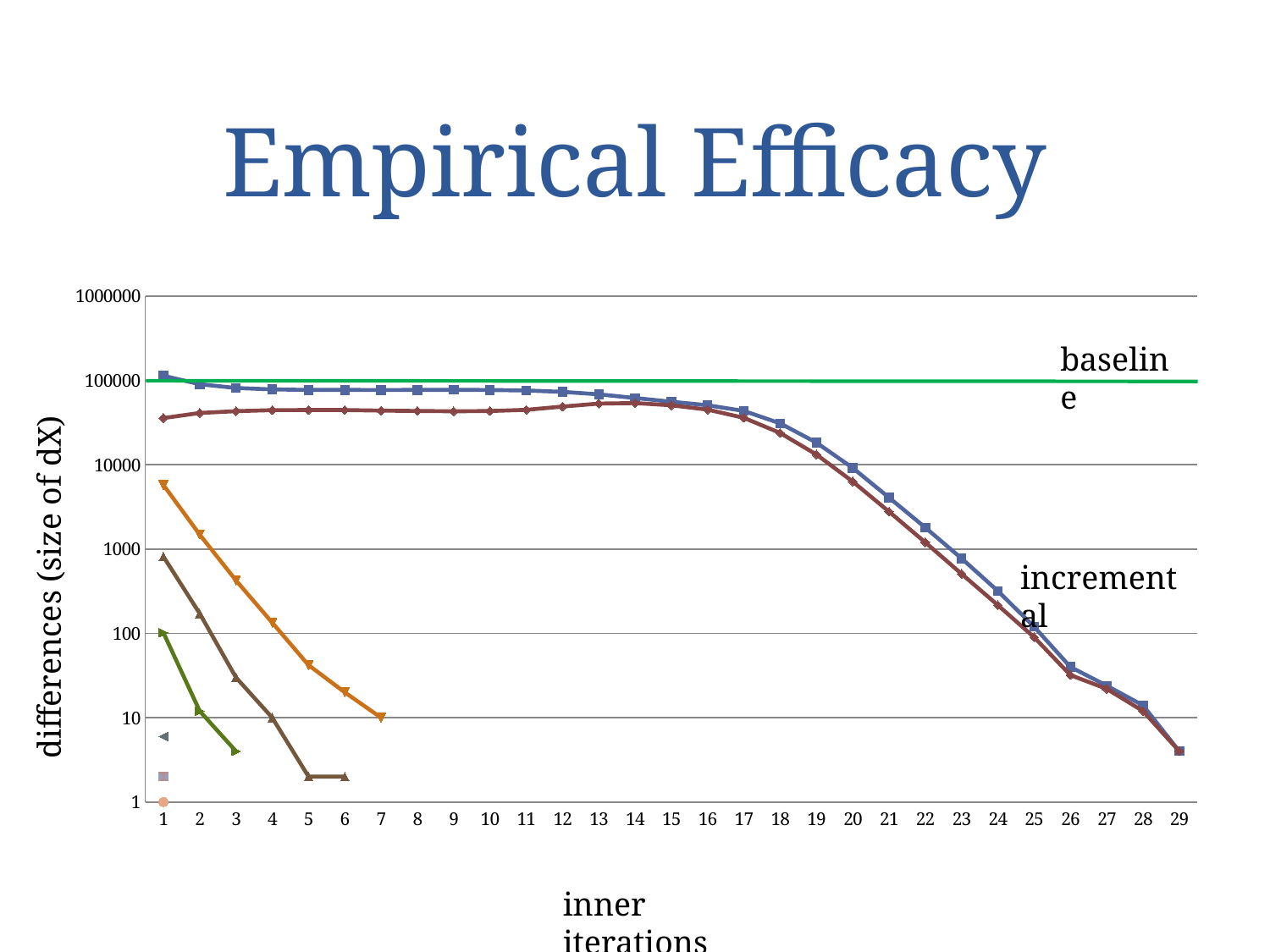
How many inner iterations are marked along the x axis? 29 What is the highest tick value shown on the y axis? 1000000 Is the value of the blue square-marker line at inner iteration 22 greater or less than 1000? greater What is the label on the vertical axis of the chart? differences (size of dX) What kind of chart is shown on the slide? line chart At inner iteration 25, which is higher: the baseline line or the incremental line? baseline Is the value of the orange line at inner iteration 1 greater or less than 1000? greater Does the blue square-marker line rise or fall as the inner iterations increase from 1 to 29? fall At inner iteration 1, which is higher: the blue square-marker line or the orange line? the blue square-marker line Is the value of the blue square-marker line at inner iteration 26 greater or less than 100? less What is the title of the slide's chart? Empirical Efficacy